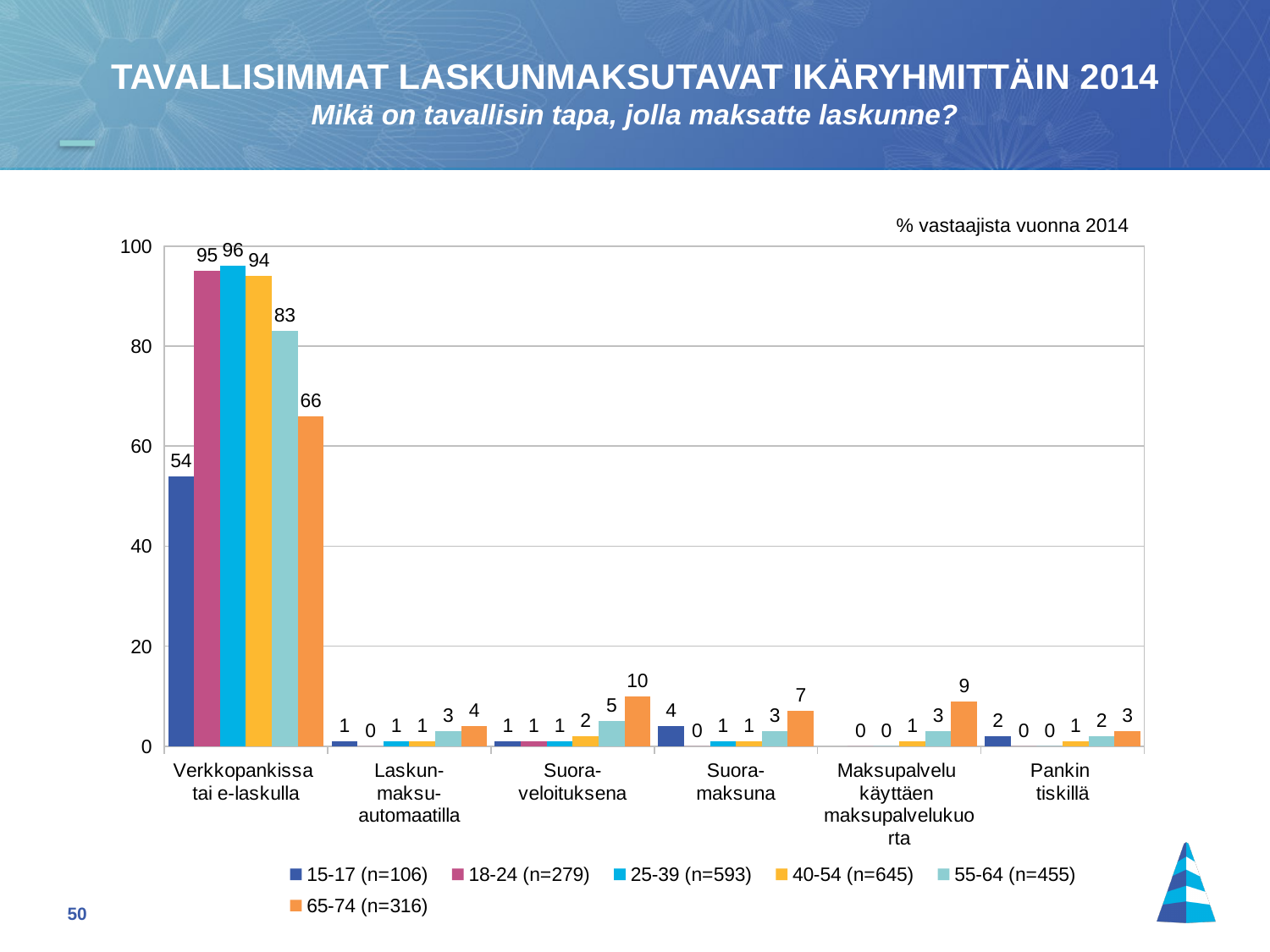
What is the value for the 55-64 age group in the Verkkopankissa tai e-laskulla category? 83 What unit is indicated in the note above the chart? % vastaajista vuonna 2014 Which age group has the lowest value in the Verkkopankissa tai e-laskulla category? 15-17 (n=106) In the Suoramaksuna category, which is larger: the value for 15-17 or the value for 65-74? 65-74 How many age-group series does the legend list? 6 What percentage of 15-17 year olds pay bills most commonly via Verkkopankissa tai e-laskulla? 54 What is the value for the 65-74 age group in the Maksupalvelu käyttäen maksupalvelukuorta category? 9 Which age group has the highest value in the Verkkopankissa tai e-laskulla category? 25-39 (n=593) What is the difference between the 25-39 and 65-74 values in the Verkkopankissa tai e-laskulla category? 30 How many payment method categories are shown on the x axis? 6 What is the value for the 65-74 age group in the Suoraveloituksena category? 10 What kind of chart is shown on the slide? Bar chart